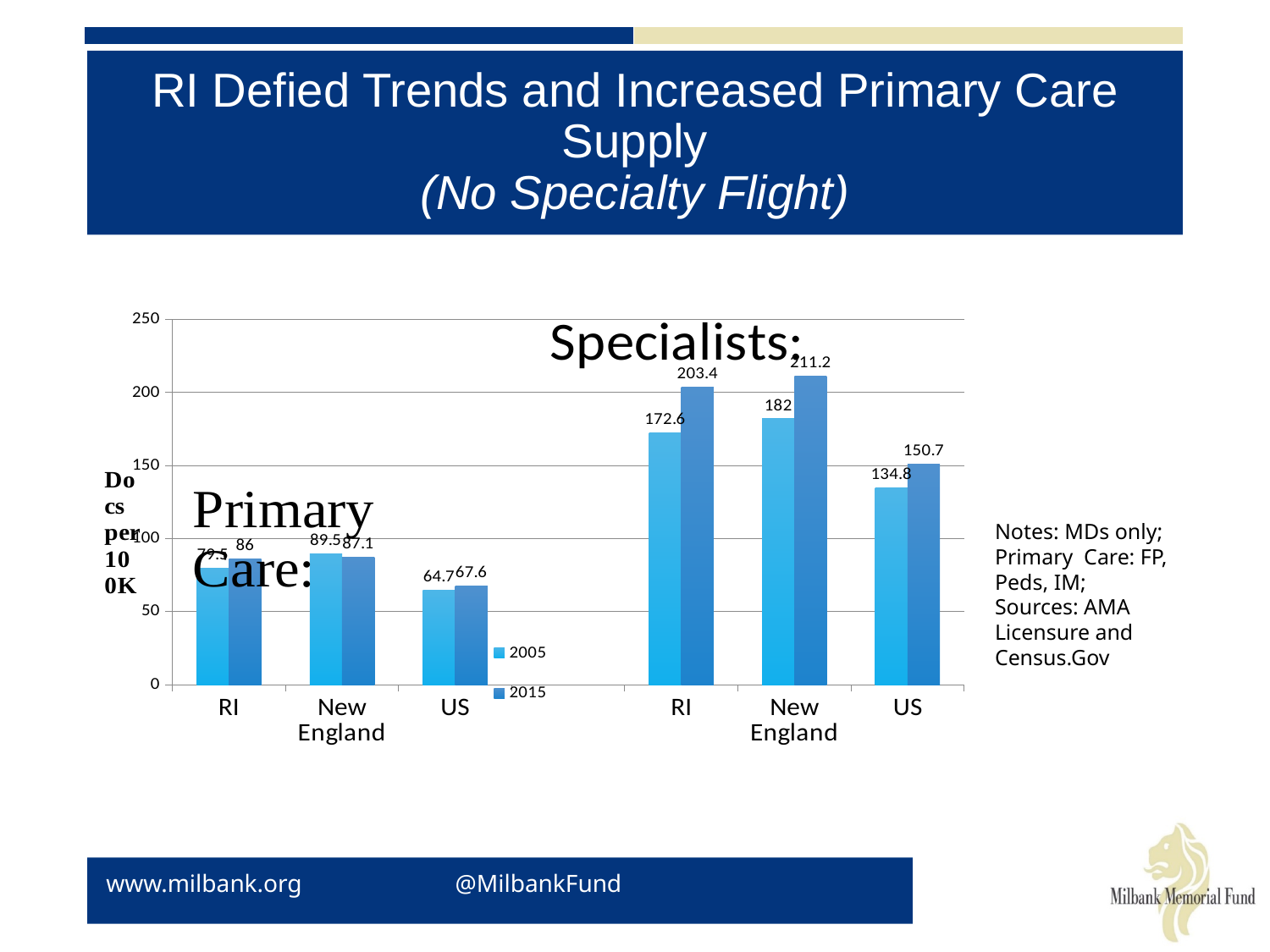
What is the difference between the 2015 and 2005 values for Specialists in the US? 15.9 Which category has the lowest 2005 value on the chart? Primary Care, US Which category has the highest 2015 value on the chart? Specialists, New England What is the 2015 value for Primary Care in RI? 86 What kind of chart is shown on the slide? bar chart How many series does the chart legend list? 2 What are the two series named in the legend? 2005 and 2015 Is the 2005 value for Specialists in RI greater or less than 150? greater What is the 2005 value for Specialists in New England? 182 What is the 2015 value for Specialists in RI? 203.4 What is the 2015 value for Primary Care in the US? 67.6 For Primary Care in New England, which is larger, the 2005 value or the 2015 value? 2005